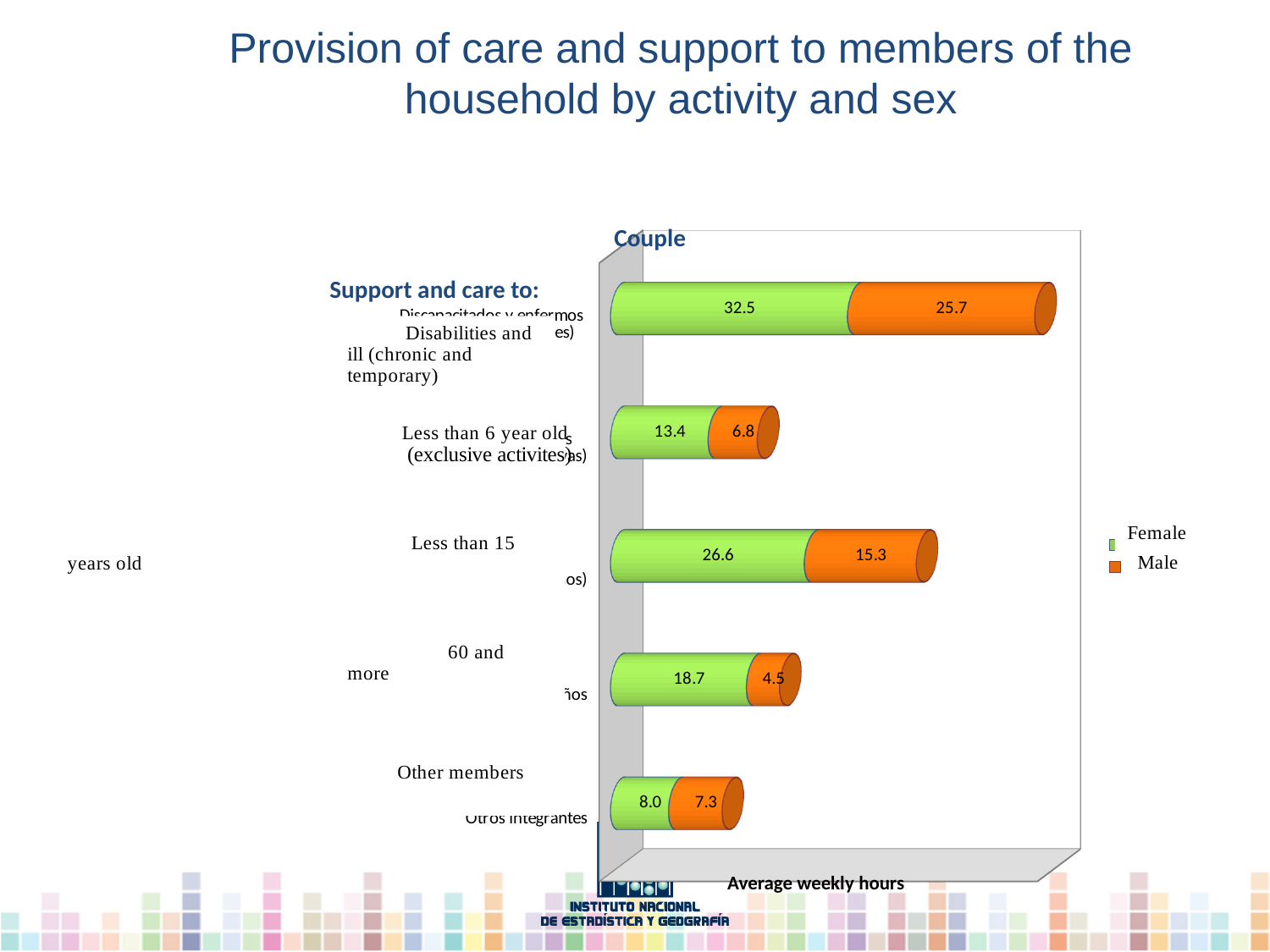
What is the Male value for 60 and more? 4.5 Which category has the highest Female value? Disabilities and ill (chronic and temporary) What is the Male value for Other members? 7.3 What is the Female value for Less than 15 years old? 26.6 What is the Female value for Disabilities and ill (chronic and temporary)? 32.5 What kind of chart is shown on the slide? Stacked bar chart What is the difference between the Female and Male values for Less than 6 years old (exclusive activities)? 6.6 Which category has the lowest Male value? 60 and more What is the total of the stacked bar for Less than 15 years old? 41.9 Which is larger, the Female value for 60 and more or the Female value for Less than 6 years old (exclusive activities)? 60 and more How many series does the legend list? 2 How many categories are shown in the chart? 5